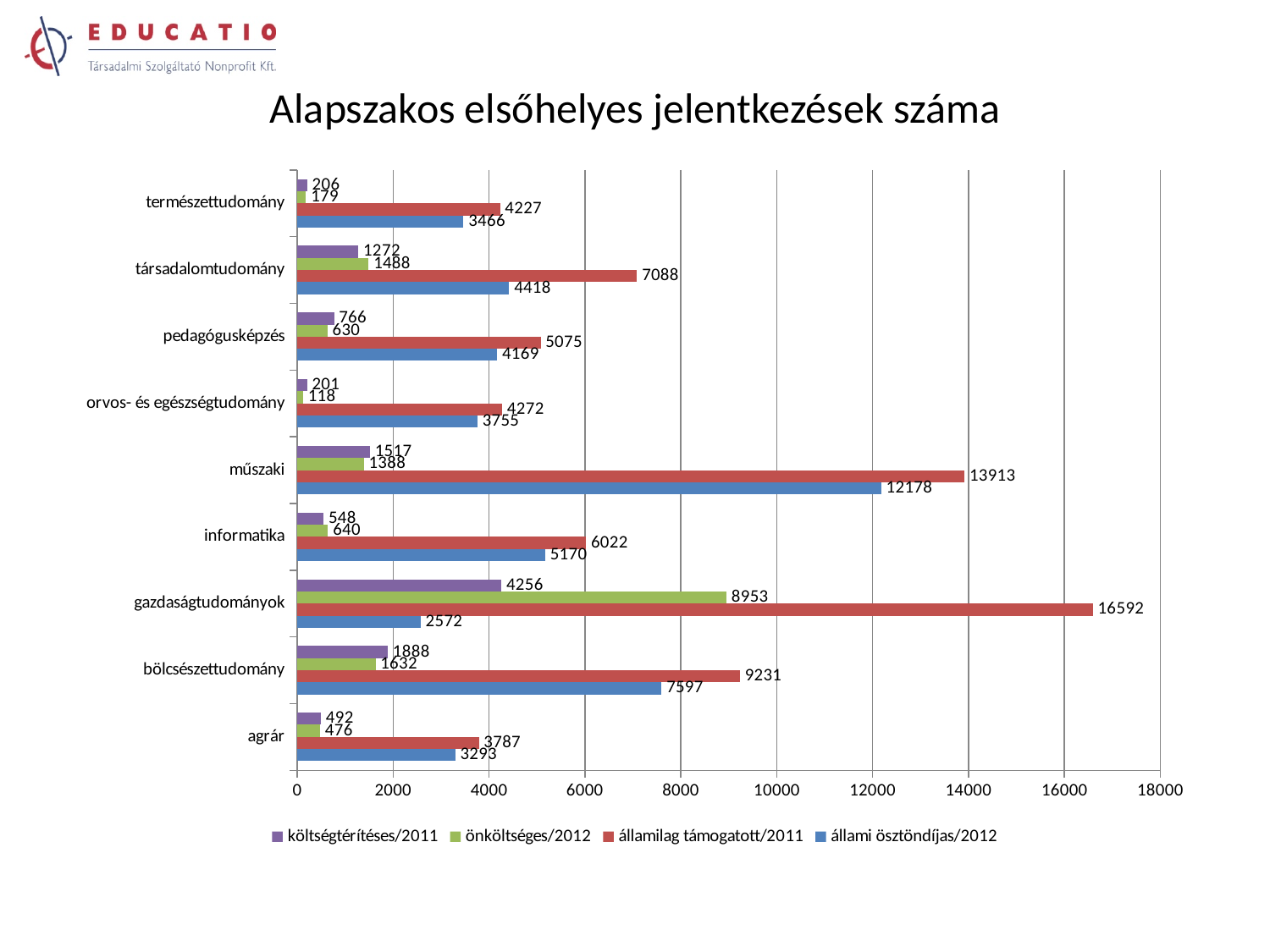
How many series does the legend list? 4 What is the difference between államilag támogatott/2011 and állami ösztöndíjas/2012 in the társadalomtudomány category? 2670 What is the value for állami ösztöndíjas/2012 in the műszaki category? 12178 What is the value for államilag támogatott/2011 in the gazdaságtudományok category? 16592 What type of chart is shown on the slide? bar chart How many categories are shown on the chart? 9 Which category has the lowest value for önköltséges/2012? orvos- és egészségtudomány What is the title of the chart? Alapszakos elsőhelyes jelentkezések száma Which is larger in the informatika category: költségtérítéses/2011 or önköltséges/2012? önköltséges/2012 What is the value for önköltséges/2012 in the bölcsészettudomány category? 1632 Which category has the highest value for állami ösztöndíjas/2012? műszaki Is the value for államilag támogatott/2011 in the bölcsészettudomány category greater or less than 8000? greater